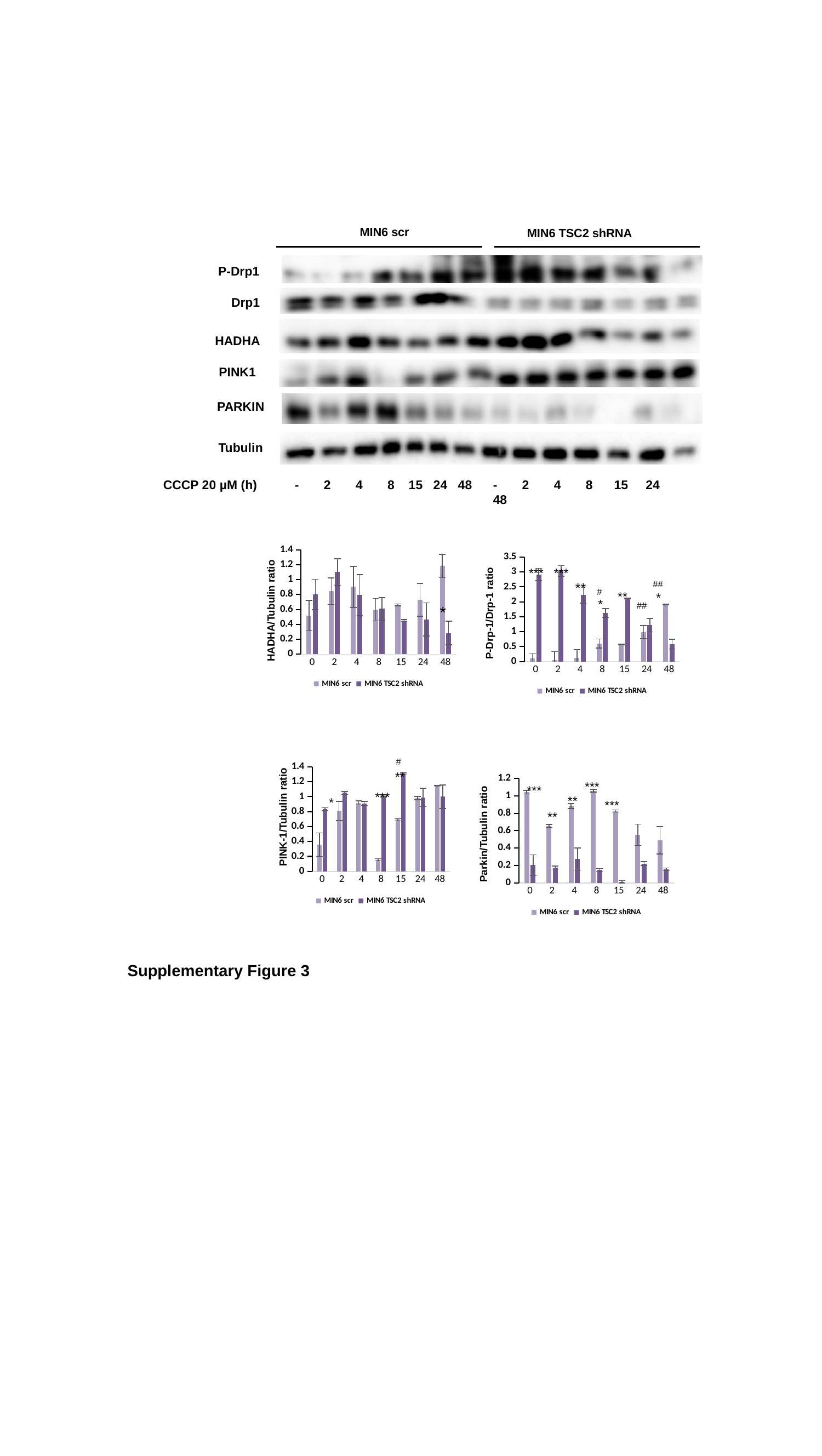
In the Parkin/Tubulin ratio chart (bottom right), at which time point is the MIN6 TSC2 shRNA value lowest? 15 In the Parkin/Tubulin ratio chart (bottom right), which series has the larger value at 8 h, MIN6 scr or MIN6 TSC2 shRNA? MIN6 scr What are the two legend entries of the HADHA/Tubulin ratio chart (top left)? MIN6 scr and MIN6 TSC2 shRNA How many series does the legend of the Parkin/Tubulin ratio chart (bottom right) list? 2 What kind of chart is the HADHA/Tubulin ratio chart (top left)? bar chart In the P-Drp-1/Drp-1 ratio chart (top right), is the value for MIN6 TSC2 shRNA at 0 h greater or less than 2.5? greater In the P-Drp-1/Drp-1 ratio chart (top right), which series has the larger value at 48 h, MIN6 scr or MIN6 TSC2 shRNA? MIN6 scr In the PINK-1/Tubulin ratio chart (bottom left), is the value for MIN6 scr at 8 h greater or less than 0.4? less How many time-point categories are shown on the x axis of the PINK-1/Tubulin ratio chart (bottom left)? 7 In the Parkin/Tubulin ratio chart (bottom right), is the value for MIN6 scr at 0 h greater or less than 0.8? greater In the PINK-1/Tubulin ratio chart (bottom left), at which time point is the MIN6 TSC2 shRNA value highest? 15 In the P-Drp-1/Drp-1 ratio chart (top right), at which time point is the MIN6 scr value highest? 48